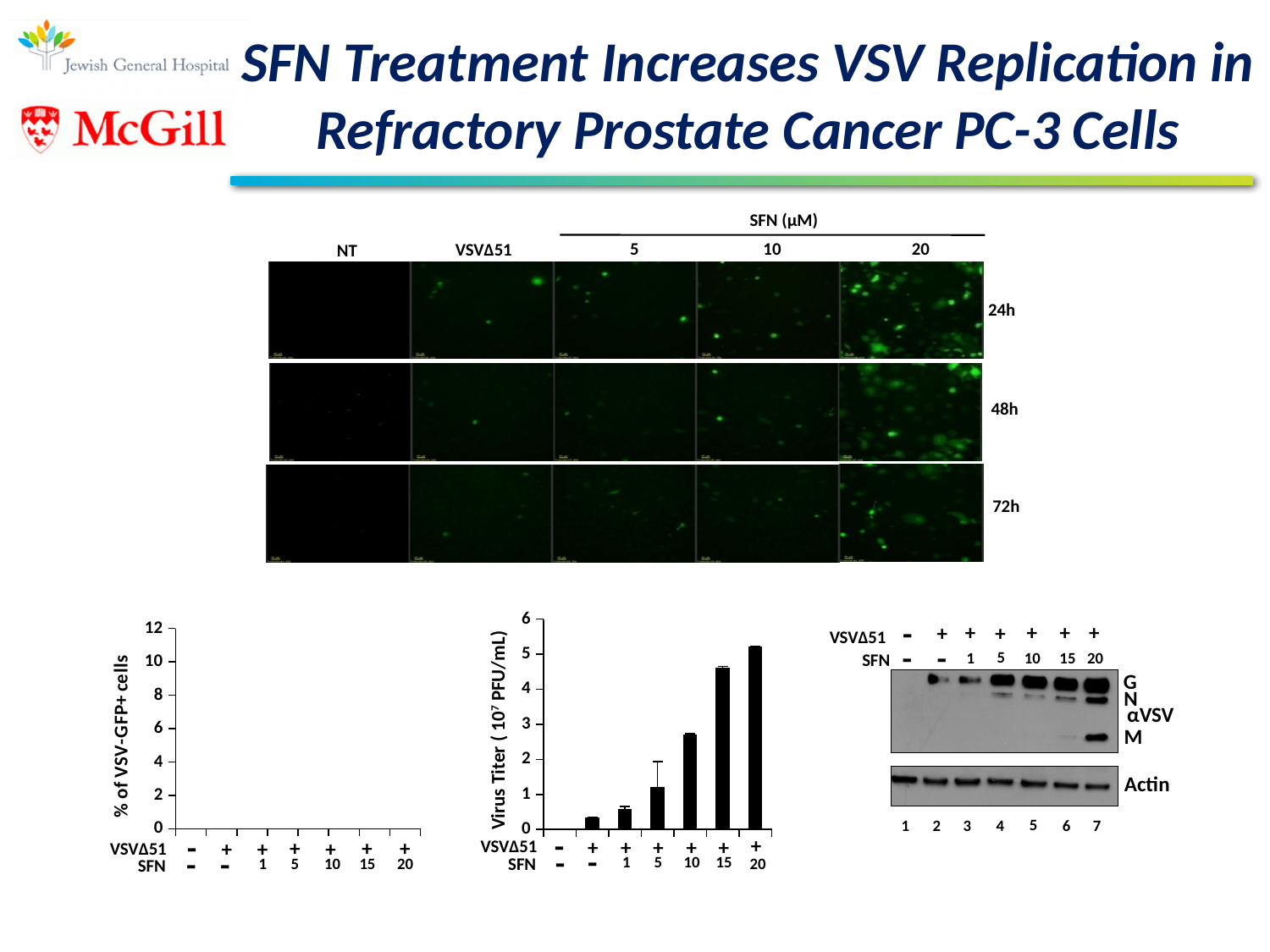
In the Virus Titer chart, is the virus titer for VSVΔ51 with 1 µM SFN greater or less than 1? less In the Virus Titer chart, which SFN concentration gives the highest virus titer? 20 In the Virus Titer chart, is the virus titer for VSVΔ51 with 15 µM SFN greater or less than 4? greater In the Virus Titer chart, do the virus titer values rise or fall as the SFN concentration increases from 1 to 20? rise In the Virus Titer chart, how many bars (treatment conditions) are plotted along the x axis? 7 What is the y-axis label of the Virus Titer chart? Virus Titer ( 10⁷ PFU/mL) In the Virus Titer chart, is the virus titer for VSVΔ51 with 10 µM SFN greater or less than 3? less What is the y-axis label of the leftmost chart on the slide? % of VSV-GFP+ cells What kind of chart is the Virus Titer chart in the middle of the slide? bar chart In the Virus Titer chart, which has the larger virus titer: VSVΔ51 with 10 µM SFN or VSVΔ51 with 15 µM SFN? VSVΔ51 with 15 µM SFN